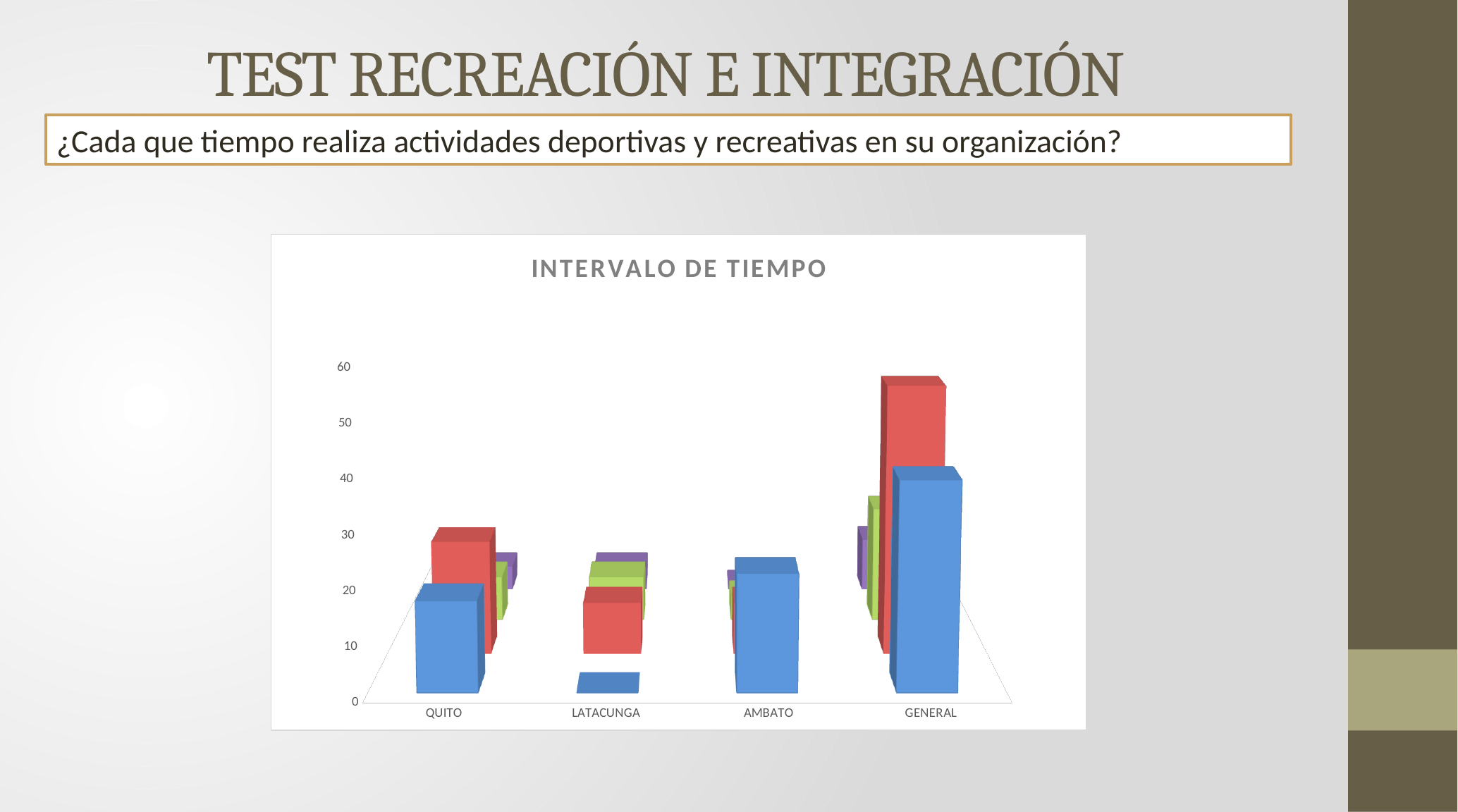
What kind of chart is shown on the slide? Bar chart Which has the larger blue bar, QUITO or LATACUNGA? QUITO Is the value of the red bar for GENERAL greater or less than 40? greater Is the value of the blue bar for LATACUNGA greater or less than 10? less Which category has the shortest blue bar? LATACUNGA How many categories are shown on the x axis of the chart? 4 Which category has the tallest red bar? GENERAL What is the title of the chart? INTERVALO DE TIEMPO For LATACUNGA, which is larger, the red bar or the blue bar? The red bar Is the value of the blue bar for QUITO greater or less than 30? less For GENERAL, which is larger, the red bar or the blue bar? The red bar Which category has the tallest bar in the chart? GENERAL